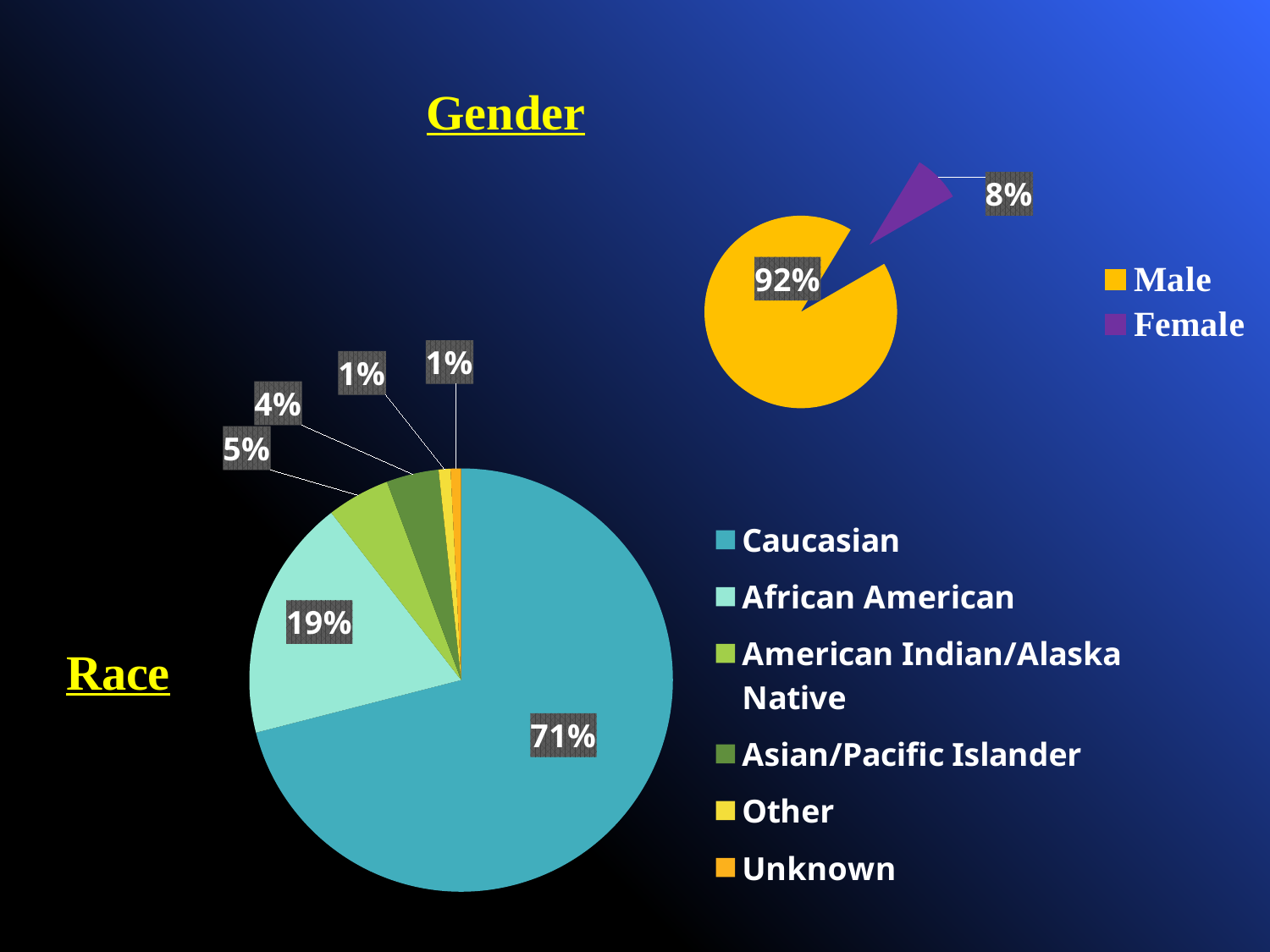
In the Gender pie chart, what percentage is Female? 8% In the Gender pie chart, what percentage is Male? 92% In the Race pie chart, what percentage is American Indian/Alaska Native? 5% How many series does the legend of the Gender chart list? 2 In the Race pie chart, which category has the largest share? Caucasian In the Gender pie chart, what is the difference between the Male and Female shares? 84% In the Race pie chart, what is the difference between the Caucasian and African American shares? 52% In the Race pie chart, which is larger, African American or Asian/Pacific Islander? African American In the Race pie chart, what percentage is African American? 19% In the Race pie chart, what percentage is Caucasian? 71% How many categories does the legend of the Race chart list? 6 What kind of chart is the Race chart? Pie chart